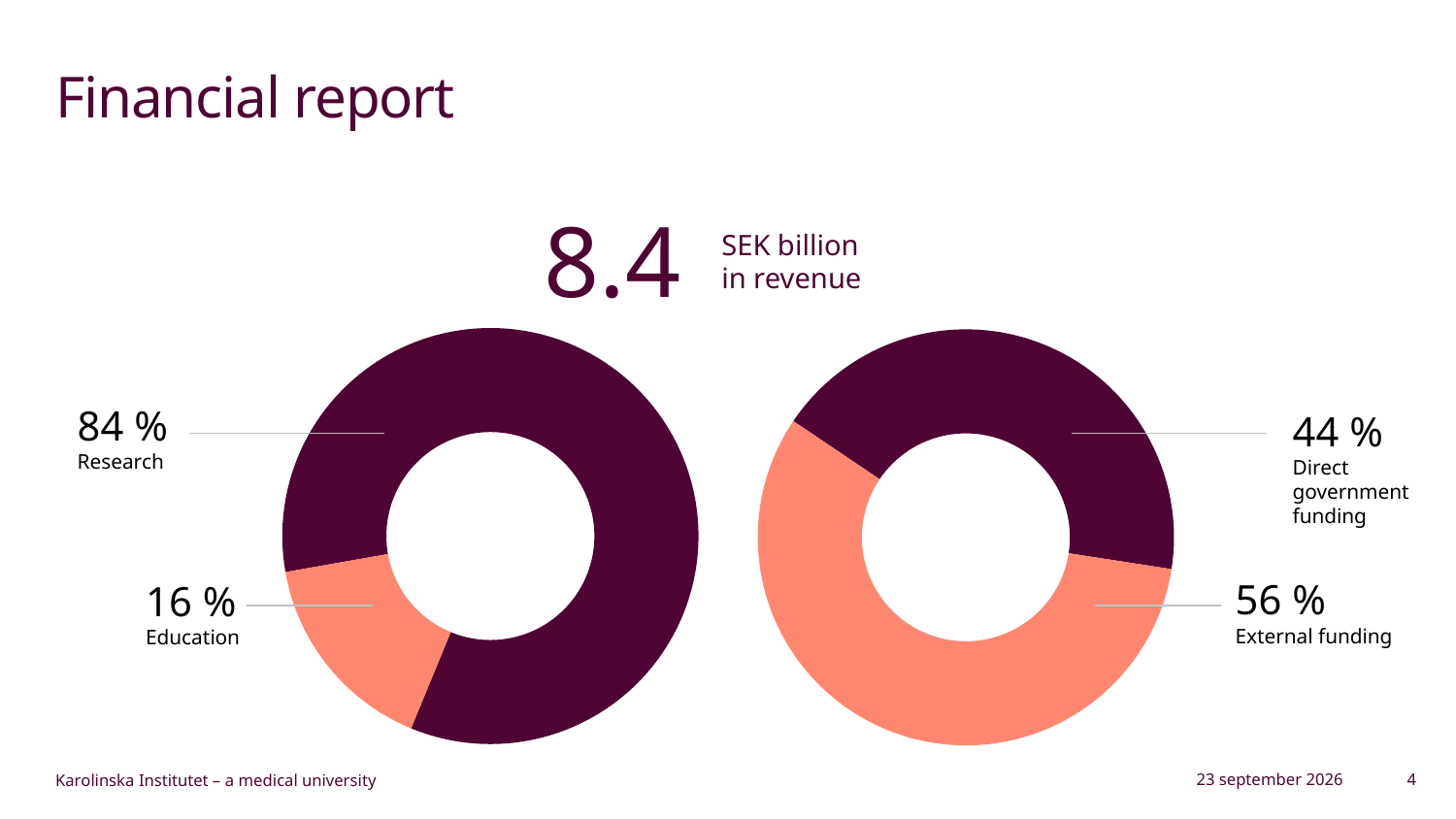
In the left donut chart, what is the difference in percentage points between Research and Education? 68 In the right donut chart, what share is labelled for External funding? 56 % In the left donut chart, what share is labelled for Research? 84 % In the right donut chart, which is larger: External funding or Direct government funding? External funding In the right donut chart, what share is labelled for Direct government funding? 44 % In the right donut chart, what is the difference in percentage points between External funding and Direct government funding? 12 What kind of chart is used on the slide to show the Research and Education split? Donut (pie) chart What total revenue figure is shown above the charts? 8.4 SEK billion In the left donut chart, which category has the largest share? Research How many categories does the left donut chart show? 2 In the left donut chart, what share is labelled for Education? 16 % In the right donut chart, which category has the smallest share? Direct government funding